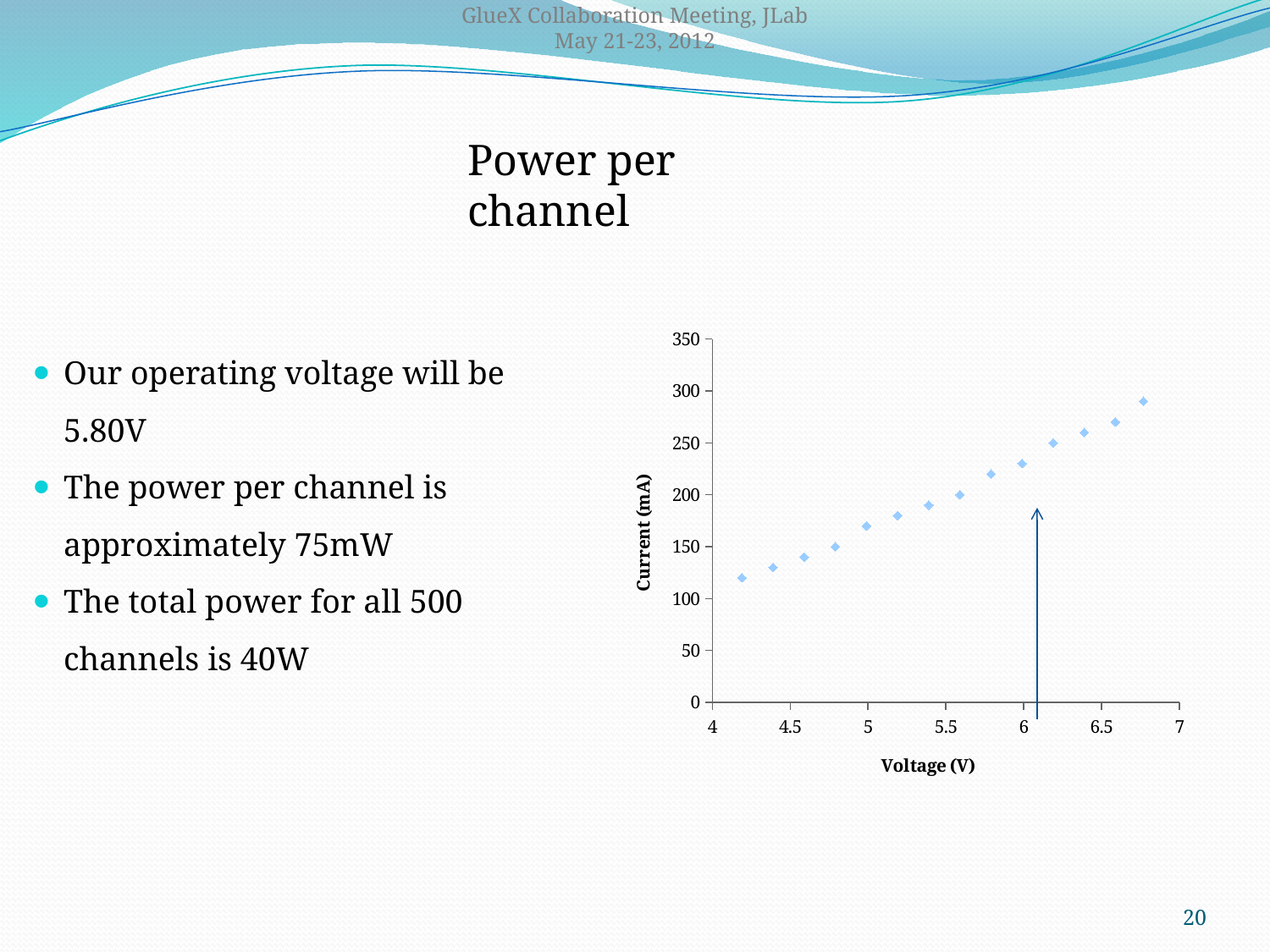
Is the current at 6 V greater or less than 200 mA? greater Is the current at 5 V greater or less than 150 mA? greater Is the current at 5 V greater or less than 200 mA? less Does the current rise or fall as the voltage increases along the x axis? rise What is the title of the x axis of the chart? Voltage (V) What kind of chart is shown on the slide? scatter chart Which has the larger current, the point at 5 V or the point at 6 V? 6 V What is the title of the y axis of the chart? Current (mA) How many data points are plotted on the chart? 14